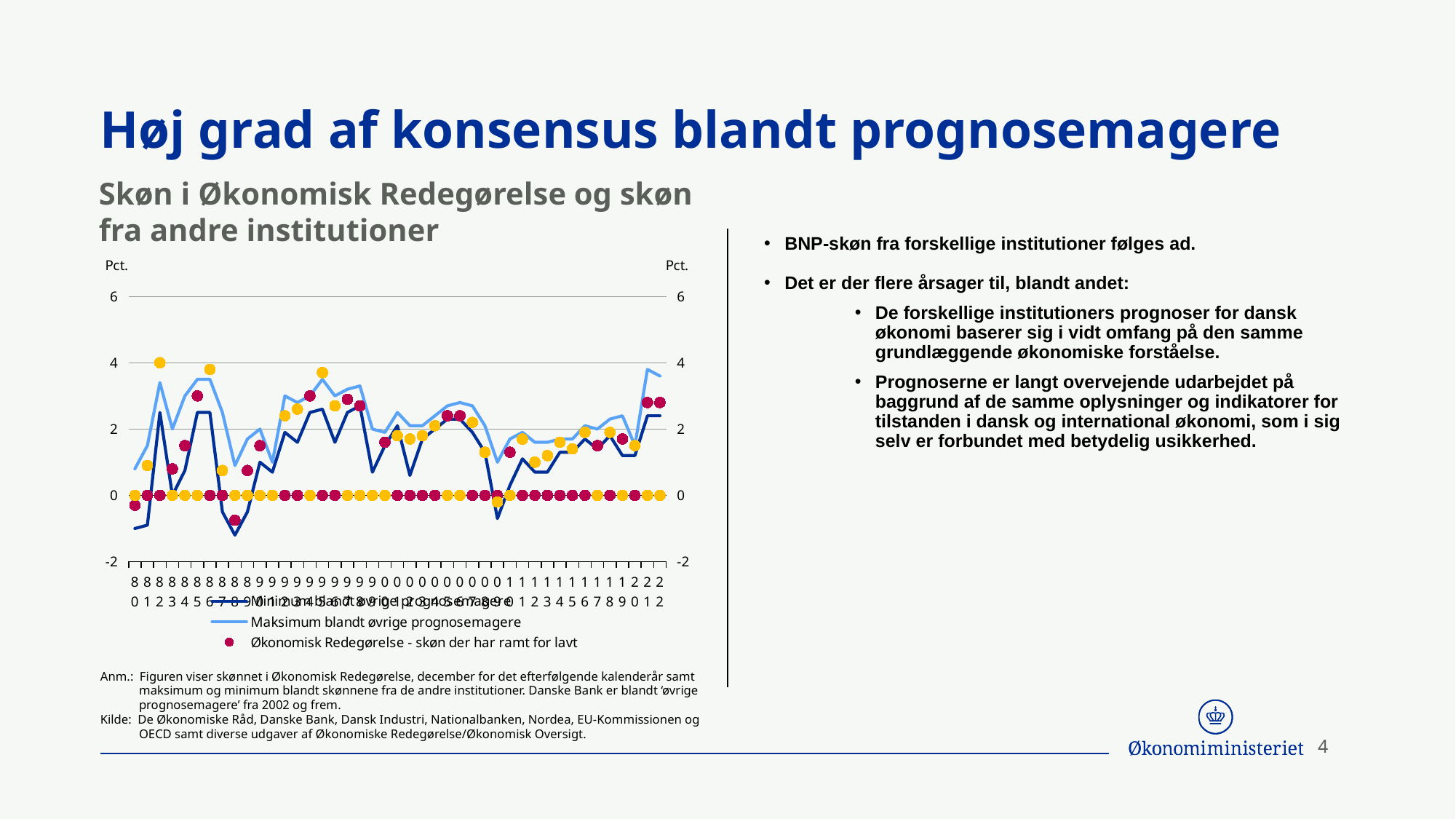
Which legend entry is represented by the light blue line? Maksimum blandt øvrige prognosemagere Does the 'Maksimum blandt øvrige prognosemagere' line ever exceed 6 on the chart? No What unit is shown on the vertical axes of the chart? Pct. Is the value of the 'Maksimum blandt øvrige prognosemagere' line at the last point on the x axis greater or less than 2? greater Is the peak value of the 'Maksimum blandt øvrige prognosemagere' line greater or less than 2? greater What is the highest tick value shown on the vertical axis of the chart? 6 What is the title of the chart on the slide? Skøn i Økonomisk Redegørelse og skøn fra andre institutioner What is the lowest tick value shown on the vertical axis of the chart? -2 What kind of chart is shown on the slide? Line chart